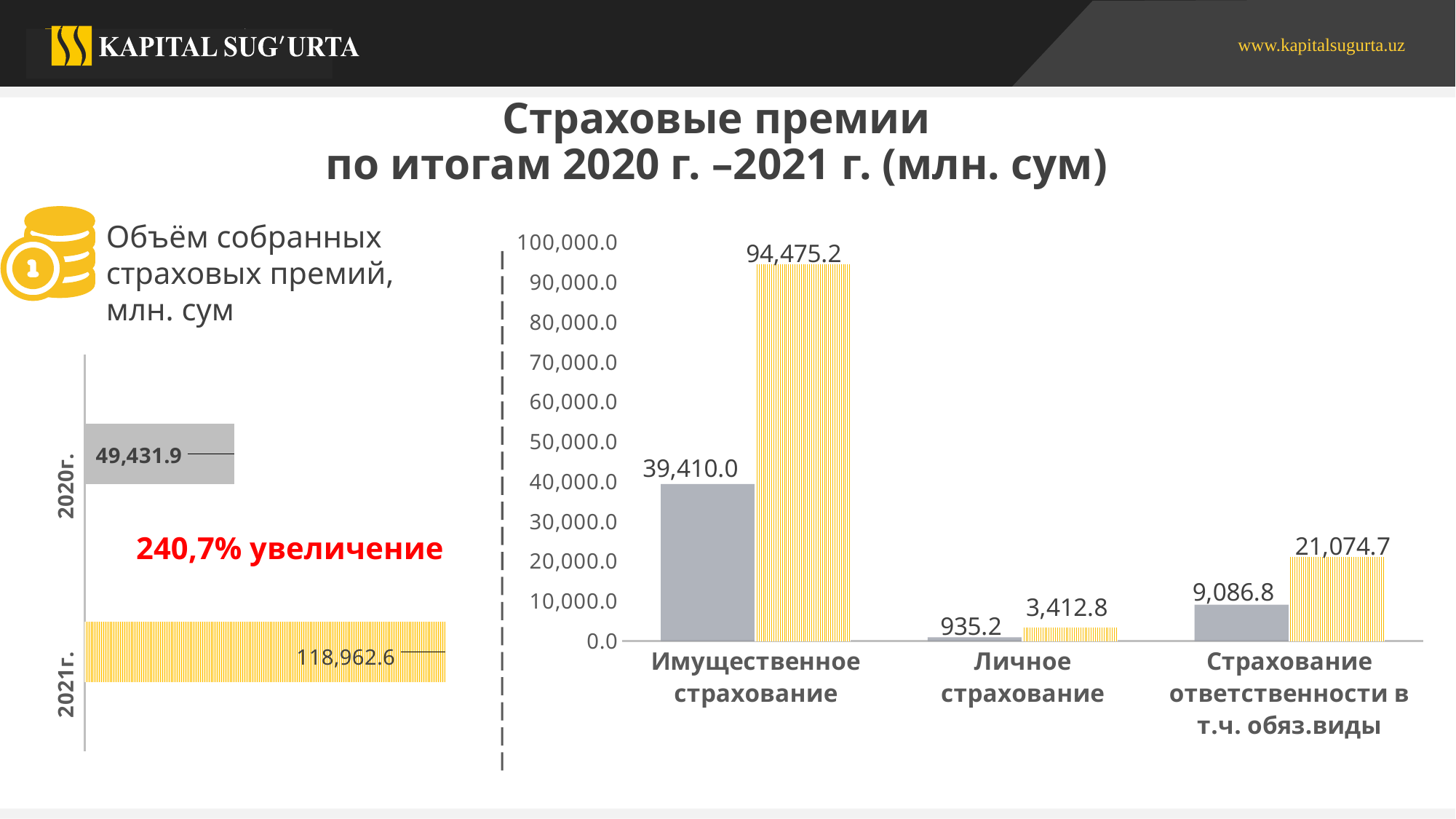
In the right chart, is the yellow bar for Страхование ответственности в т.ч. обяз.виды greater or less than 20,000.0? greater In the right chart, how many categories are shown on the x axis? 3 In the right chart, what is the difference between the yellow and grey bars for Имущественное страхование? 55,065.2 In the right chart, which category has the highest bar? Имущественное страхование In the right chart, what is the value of the yellow bar for Имущественное страхование? 94,475.2 In the right chart, what is the value of the grey bar for Страхование ответственности в т.ч. обяз.виды? 9,086.8 In the right chart, what is the value of the grey bar for Личное страхование? 935.2 In the left chart, what is the difference between the 2021г. and 2020г. values? 69,530.7 In the left chart, what is the value for 2021г.? 118,962.6 In the left chart, what is the value for 2020г.? 49,431.9 In the right chart, which category has the lowest grey bar? Личное страхование What kind of chart is the left chart? Bar chart